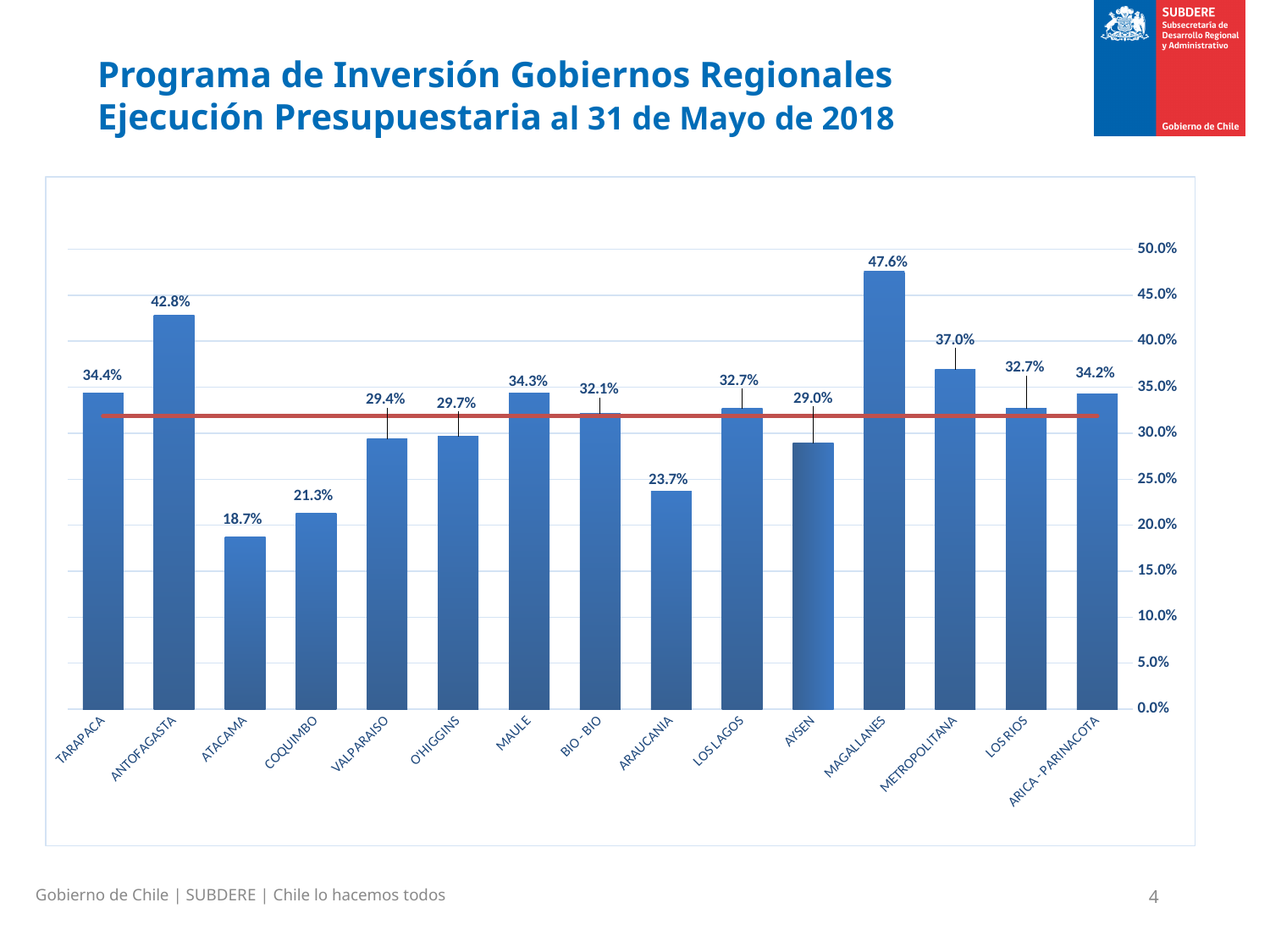
What is the value for ATACAMA? 18.7% What is the value for MAGALLANES? 47.6% Is the value for AYSEN greater or less than 30.0%? less Which region has the highest value? MAGALLANES What is the value for METROPOLITANA? 37.0% What kind of chart is shown on the slide? bar chart Which is larger, the value for ANTOFAGASTA or the value for METROPOLITANA? ANTOFAGASTA What is the value for ARAUCANIA? 23.7% How many regions are shown on the x axis? 15 What is the difference between the values for ANTOFAGASTA and COQUIMBO? 21.5% What is the difference between the values for MAGALLANES and ATACAMA? 28.9% Which region has the lowest value? ATACAMA